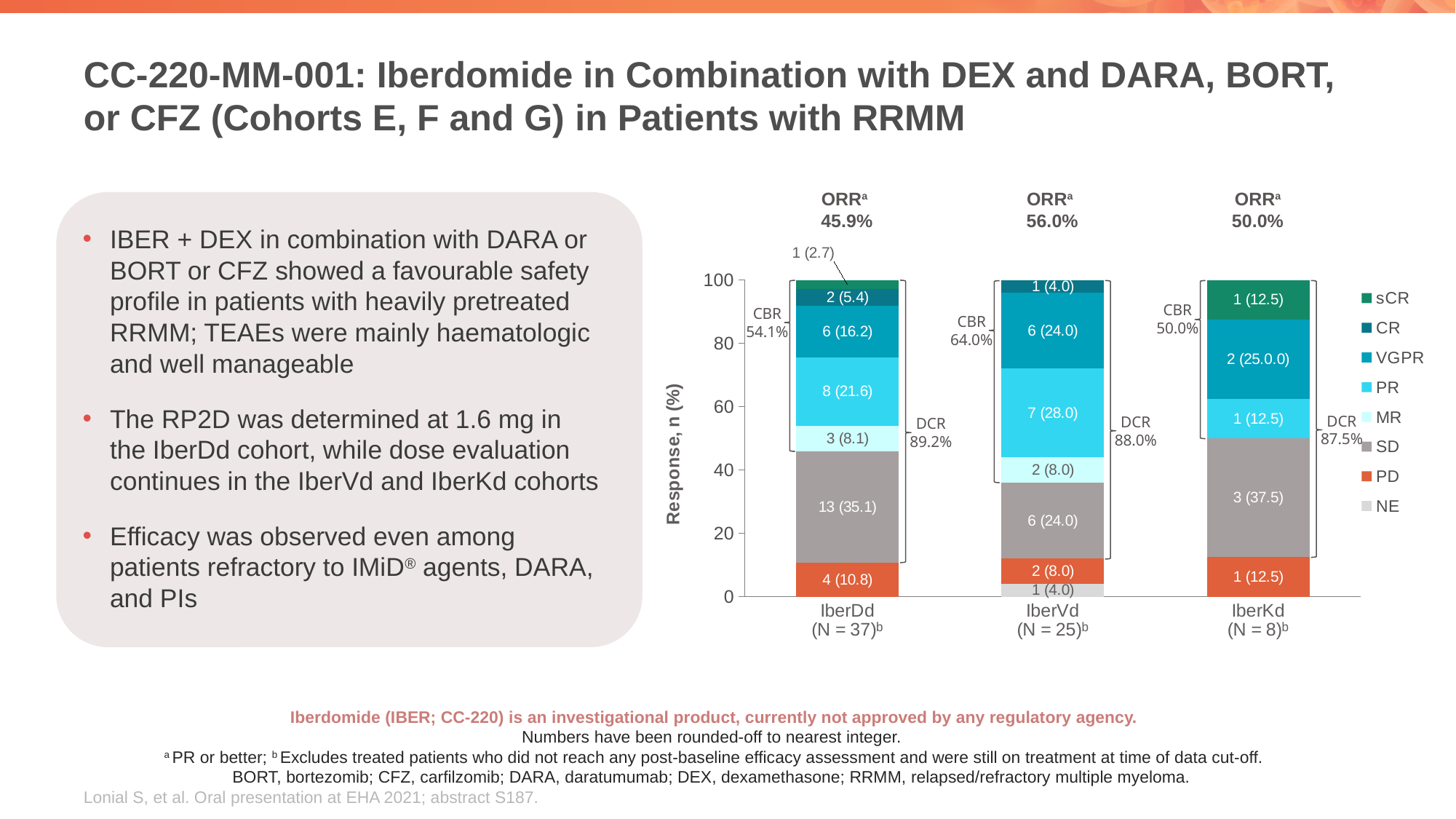
What type of chart is shown on the slide? Stacked bar chart How many series does the chart legend list? 8 How many more SD patients are in the IberDd cohort than in the IberVd cohort? 7 What is the DCR shown for the IberVd cohort? 88.0% What is the SD value (n and %) for the IberDd cohort? 13 (35.1) What is the label of the y axis of the chart? Response, n (%) What is the ORR shown for the IberKd cohort? 50.0% What is the PR value (n and %) for the IberVd cohort? 7 (28.0) Which cohort has the highest ORR? IberVd Which cohort has the lowest CBR? IberKd How many cohorts (bars) are shown on the x axis of the chart? 3 Which cohort has the larger VGPR count, IberDd or IberKd? IberDd